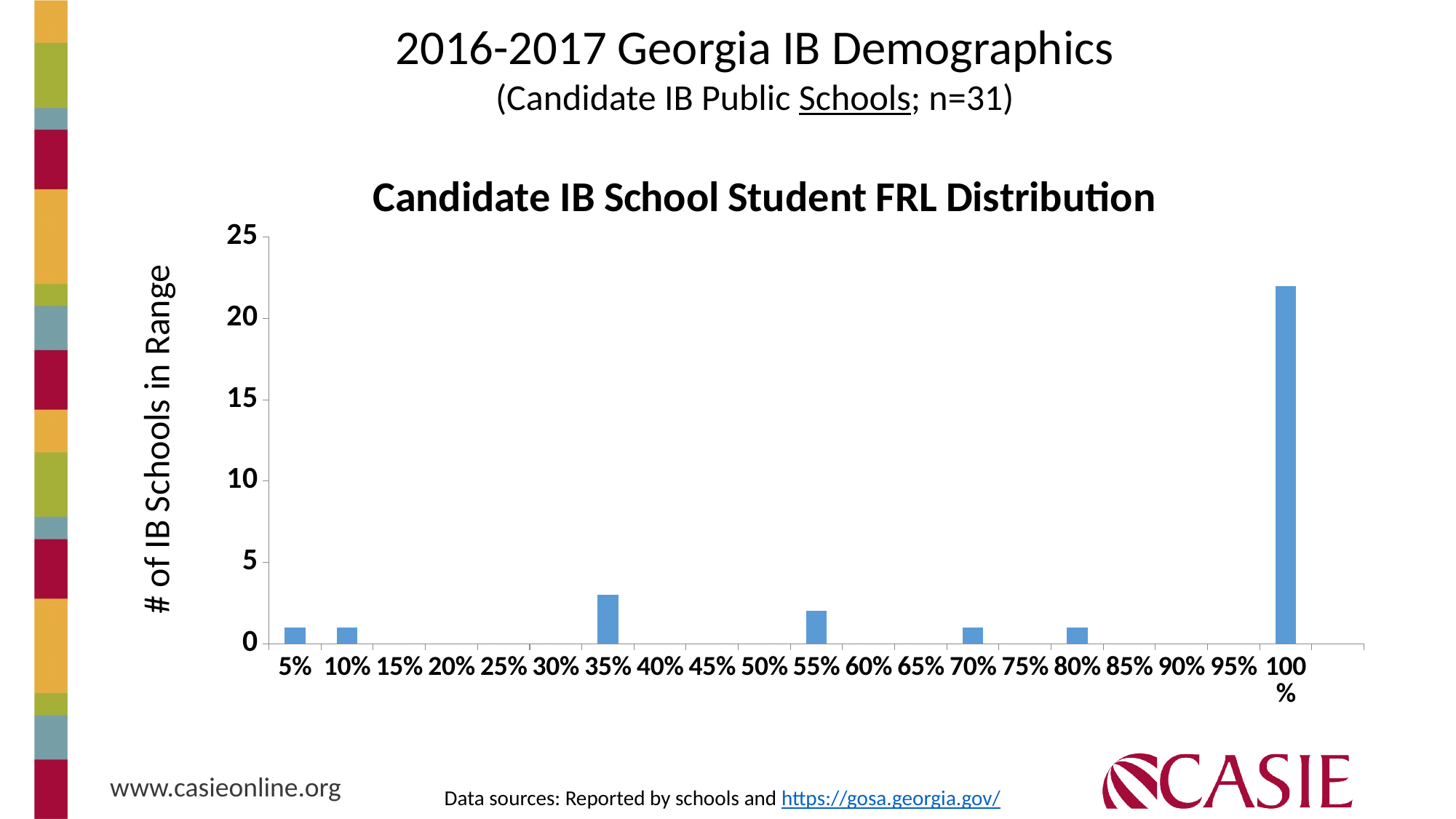
Is the value for the 55% category greater or less than 5? less Which has more IB schools, the 35% category or the 5% category? 35% What is the title of the chart? Candidate IB School Student FRL Distribution Is the value for the 100% category greater or less than 20? greater Which FRL range category has the highest number of IB schools? 100% How many FRL range categories have a visible bar (a non-zero count of schools)? 7 Is the value for the 35% category greater or less than 5? less What is the label on the vertical axis of the chart? # of IB Schools in Range What type of chart is shown on the slide? bar chart Which has more IB schools, the 100% category or the 35% category? 100% How many FRL range categories are shown along the x axis? 20